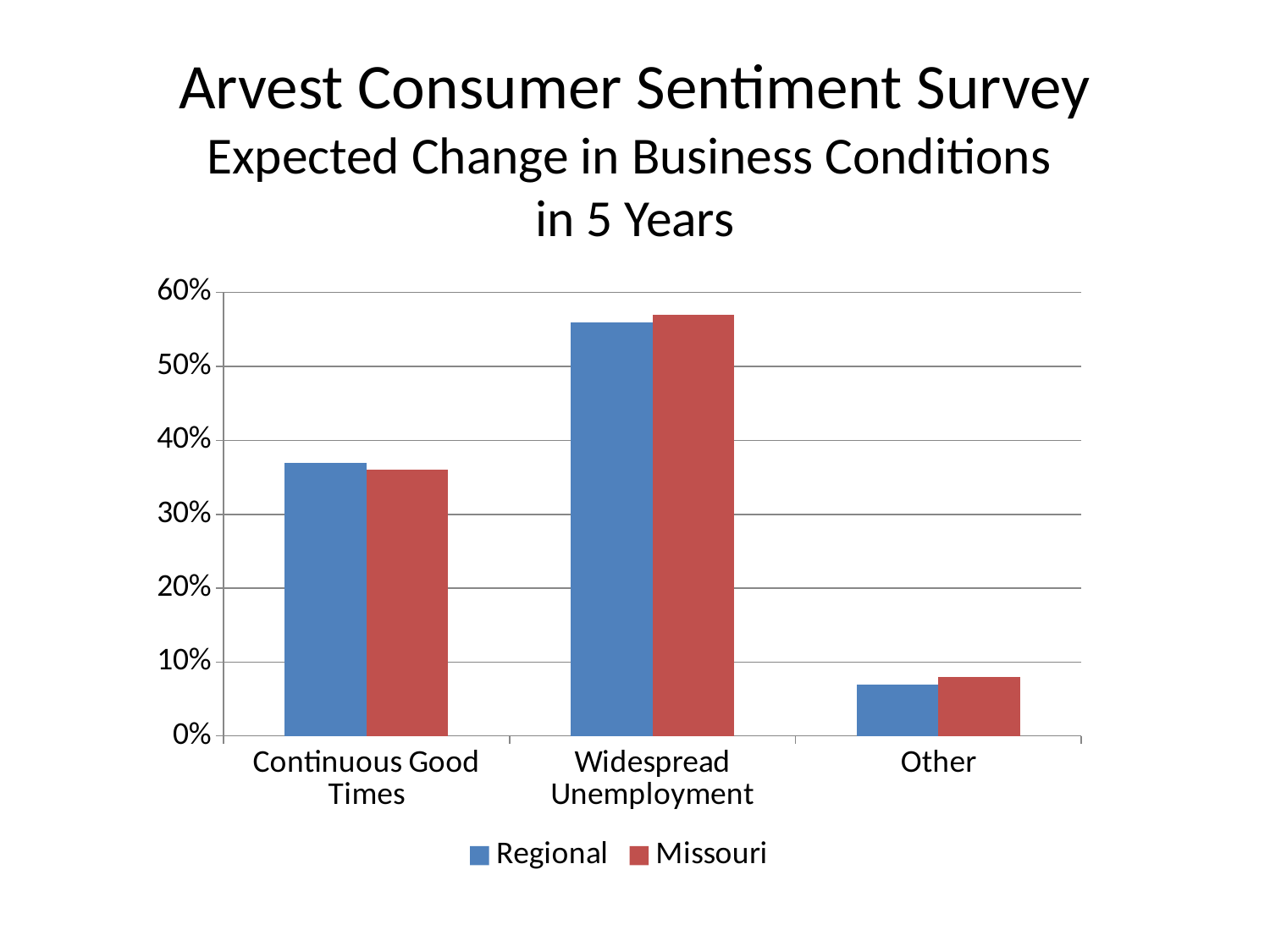
What kind of chart is shown on the slide? bar chart Which category has the lowest value for the Missouri series? Other Which is larger: the Regional value for Continuous Good Times or the Regional value for Other? Continuous Good Times Is the Regional value for Continuous Good Times greater or less than 30%? greater Which category has the highest value for the Regional series? Widespread Unemployment What are the two series listed in the legend? Regional and Missouri How many series does the legend list? 2 What colour are the Missouri bars? red Is the Missouri value for Other greater or less than 10%? less How many categories are shown on the x axis? 3 Is the Missouri value for Continuous Good Times greater or less than 40%? less